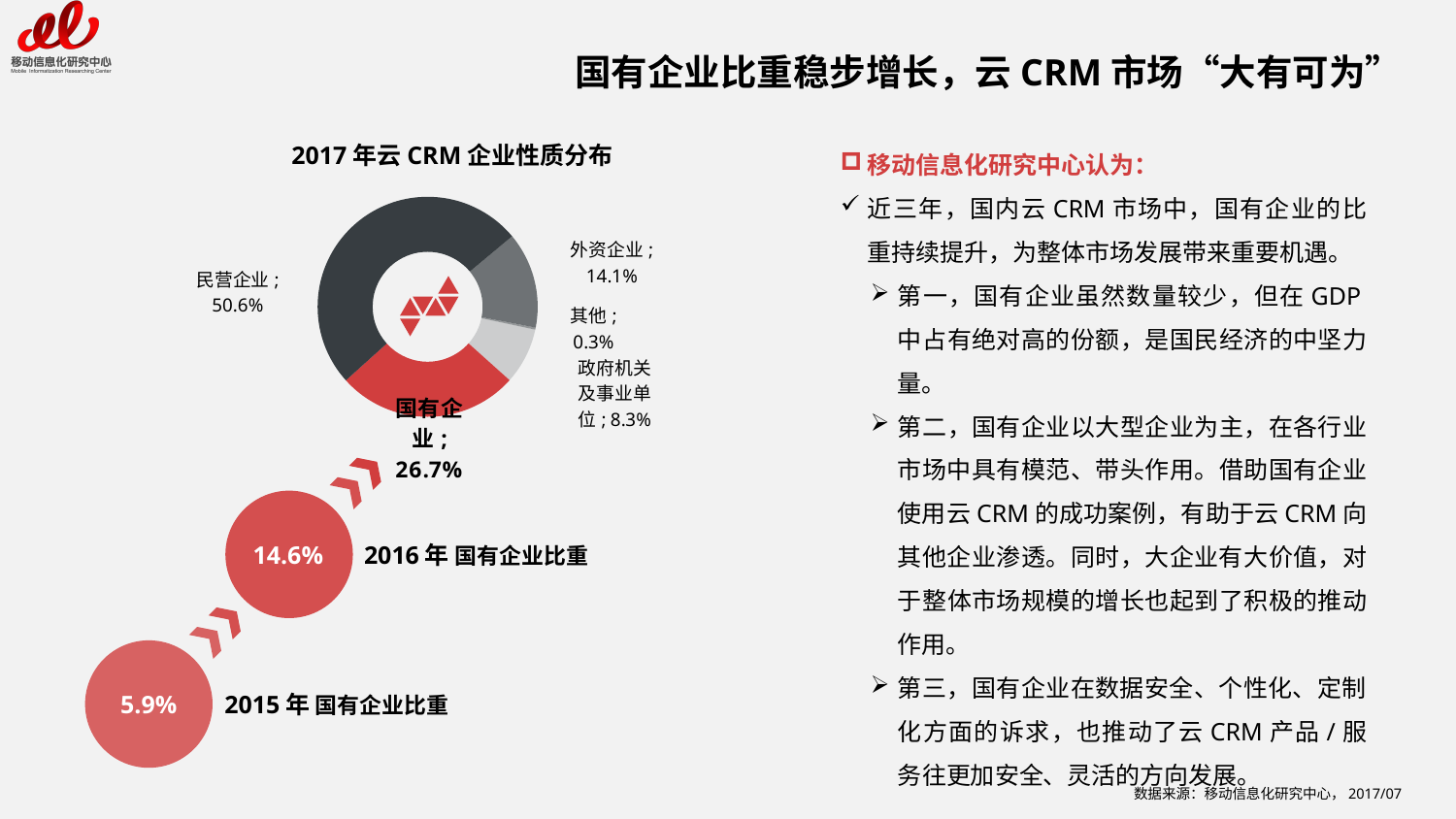
In the 2017年云CRM企业性质分布 chart, what share do 民营企业 hold? 50.6% In the 2017年云CRM企业性质分布 chart, how many categories are shown? 5 According to the slide, what was the 国有企业比重 in 2015? 5.9% What type of chart is used to show the 2017年云CRM企业性质分布? Pie (donut) chart In the 2017年云CRM企业性质分布 chart, what is the difference between the shares of 民营企业 and 国有企业? 23.9% In the 2017年云CRM企业性质分布 chart, what share do 政府机关及事业单位 hold? 8.3% In the 2017年云CRM企业性质分布 chart, what share do 国有企业 hold? 26.7% In the 2017年云CRM企业性质分布 chart, which category has the largest share? 民营企业 In the 2017年云CRM企业性质分布 chart, which is larger: the share of 外资企业 or the share of 政府机关及事业单位? 外资企业 In the 2017年云CRM企业性质分布 chart, what share do 外资企业 hold? 14.1% According to the slide, what was the 国有企业比重 in 2016? 14.6% In the 2017年云CRM企业性质分布 chart, which category has the smallest share? 其他